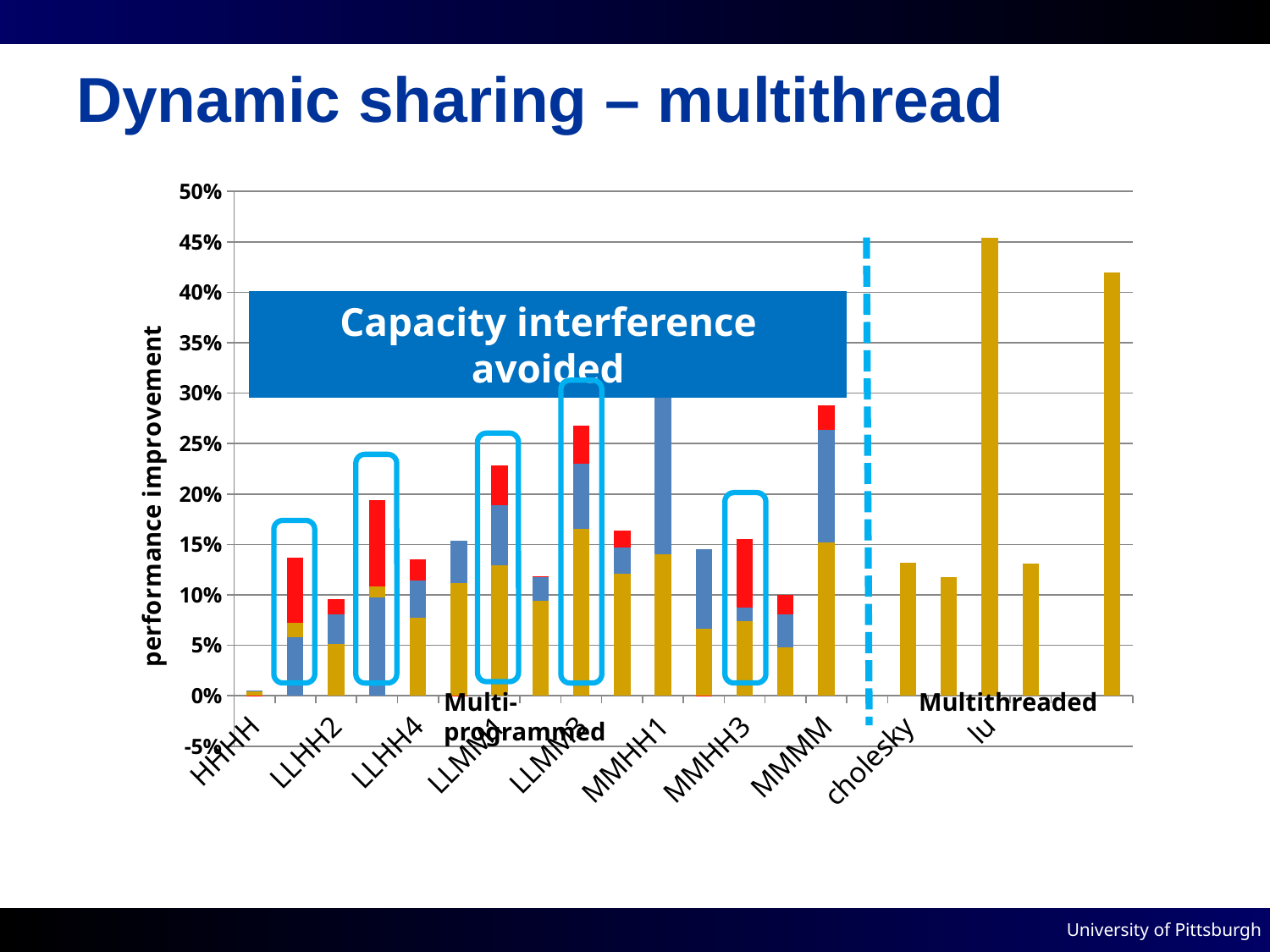
What text is written in the blue box overlaid on the chart? Capacity interference avoided Which has the larger total value, MMMM or LLHH4? MMMM What is the label of the vertical axis? performance improvement Is the value for lu greater or less than 40%? greater Is the total value for MMHH3 greater or less than 20%? less What kind of chart is shown on the slide? bar chart Which labeled category has the lowest bar? HHHH Which labeled category has the highest bar? lu Is the total value for MMMM greater or less than 25%? greater Which has the larger value, lu or cholesky? lu